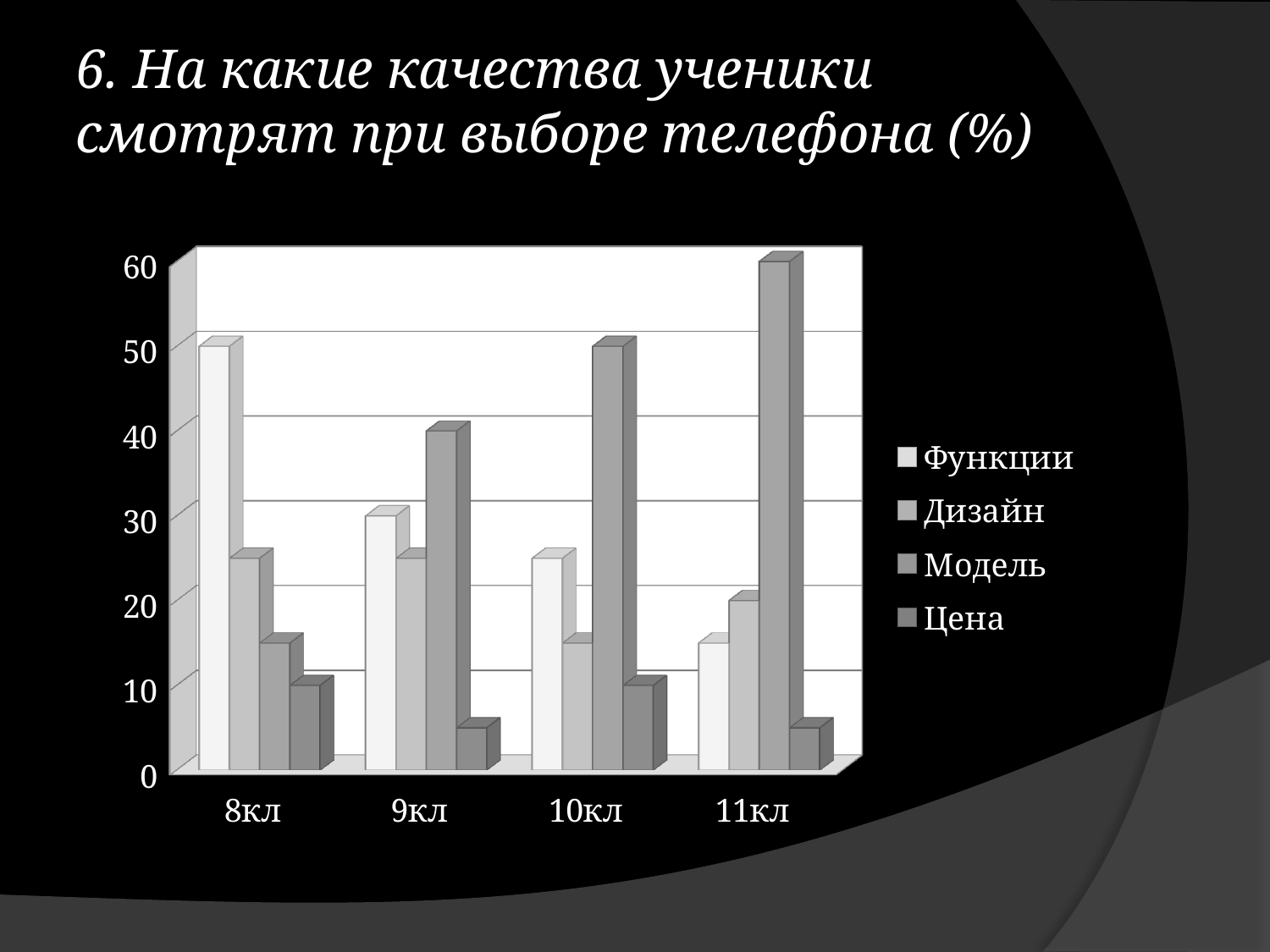
What is the value for Модель in 11кл? 60 Which class has the highest value for Модель? 11кл In 8кл, which is larger: Функции or Цена? Функции Is the value for Цена in 11кл greater or less than 10? less What is the difference between the Модель values for 11кл and 10кл? 10 What is the value for Функции in 8кл? 50 How many class categories are shown on the x axis? 4 Does the value for Модель rise or fall from 8кл to 11кл? rises How many series does the legend list? 4 Is the value for Функции in 9кл greater or less than 20? greater What kind of chart is shown on the slide? bar chart What are the four entries listed in the legend? Функции, Дизайн, Модель, Цена